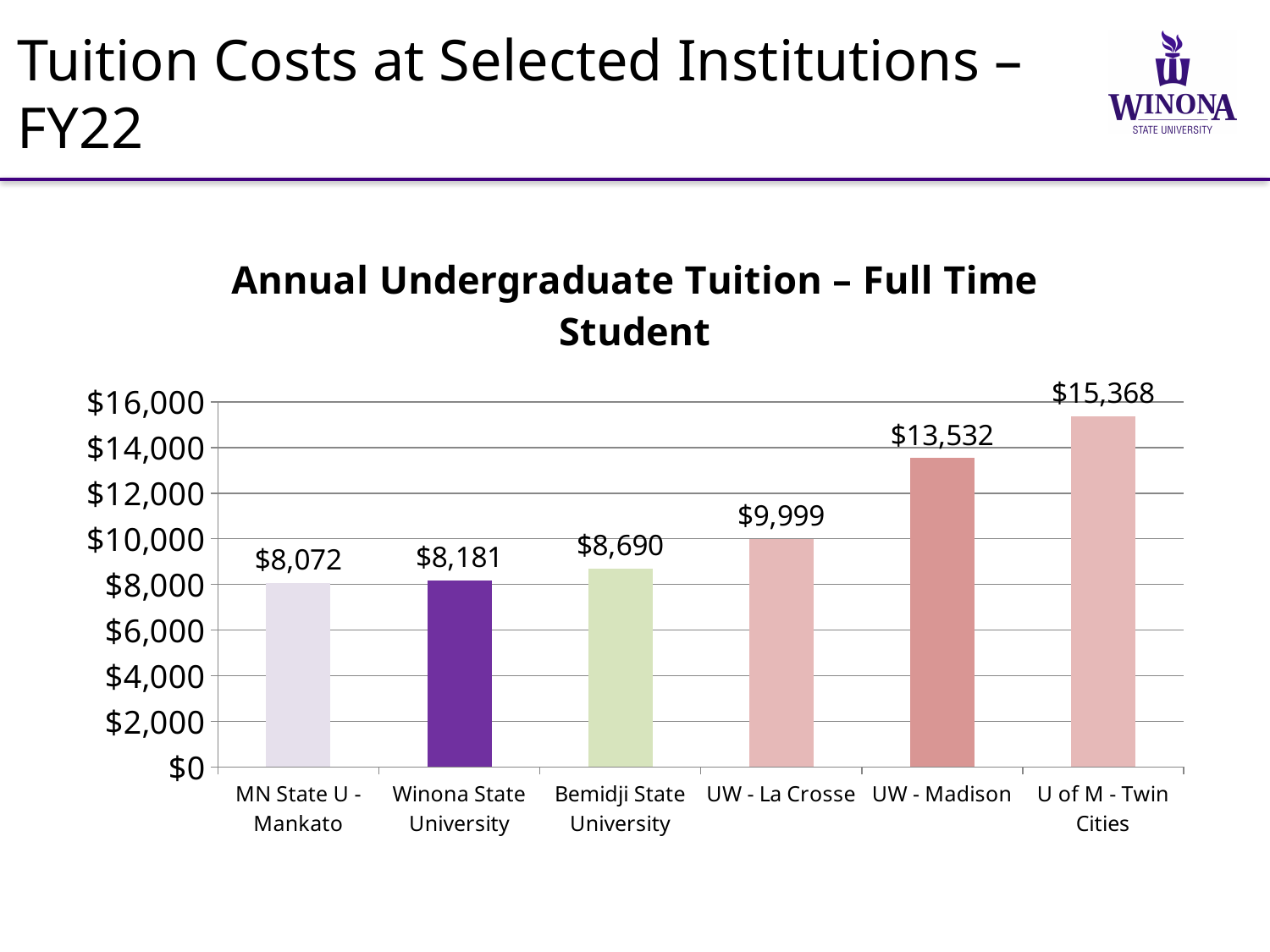
What is the title of the chart? Annual Undergraduate Tuition – Full Time Student How many institutions are shown in the chart? 6 What is the annual undergraduate tuition for Winona State University? $8,181 What is the difference in tuition between U of M - Twin Cities and UW - Madison? $1,836 Which institution has the lowest annual undergraduate tuition? MN State U - Mankato What is the difference in tuition between Winona State University and MN State U - Mankato? $109 Is the tuition for UW - Madison greater or less than $12,000? greater Which has higher tuition, UW - La Crosse or Bemidji State University? UW - La Crosse Which institution has the highest annual undergraduate tuition? U of M - Twin Cities What is the annual undergraduate tuition for Bemidji State University? $8,690 What is the annual undergraduate tuition for UW - Madison? $13,532 What kind of chart is shown on the slide? Bar chart